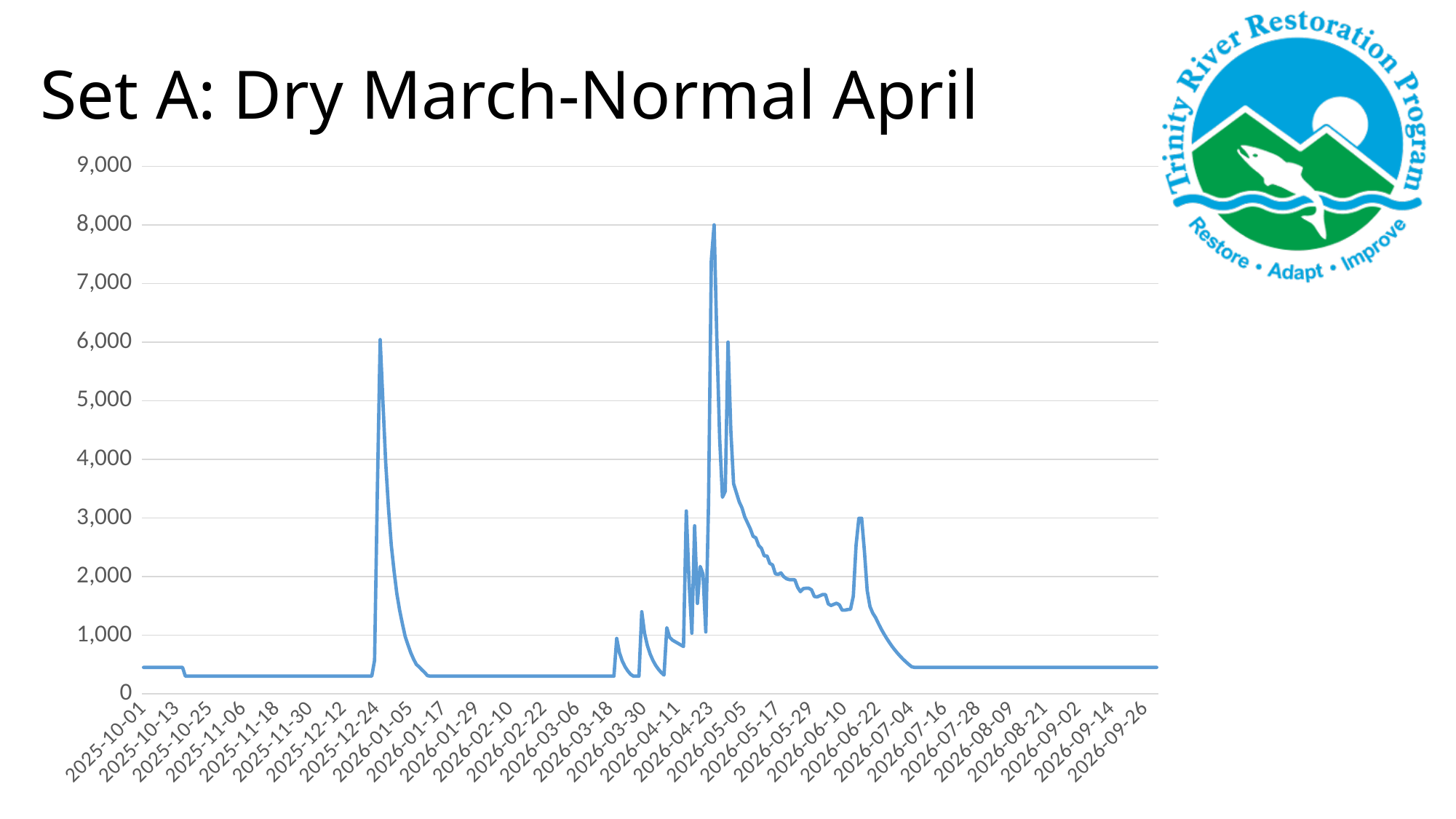
Between 2026-05-05 and 2026-06-10, does the line generally rise or fall? fall Is the value at 2026-06-10 greater or less than 2,000? less What is the title of the slide containing the chart? Set A: Dry March-Normal April Is the highest peak of the line greater or less than 7,000? greater How many date labels are shown on the x axis? 31 What kind of chart is shown on the slide? line chart Is the value at 2025-10-01 greater or less than 1,000? less What is the highest value labelled on the y axis? 9,000 Which is higher: the peak near 2025-12-24 or the peak near 2026-06-22? the peak near 2025-12-24